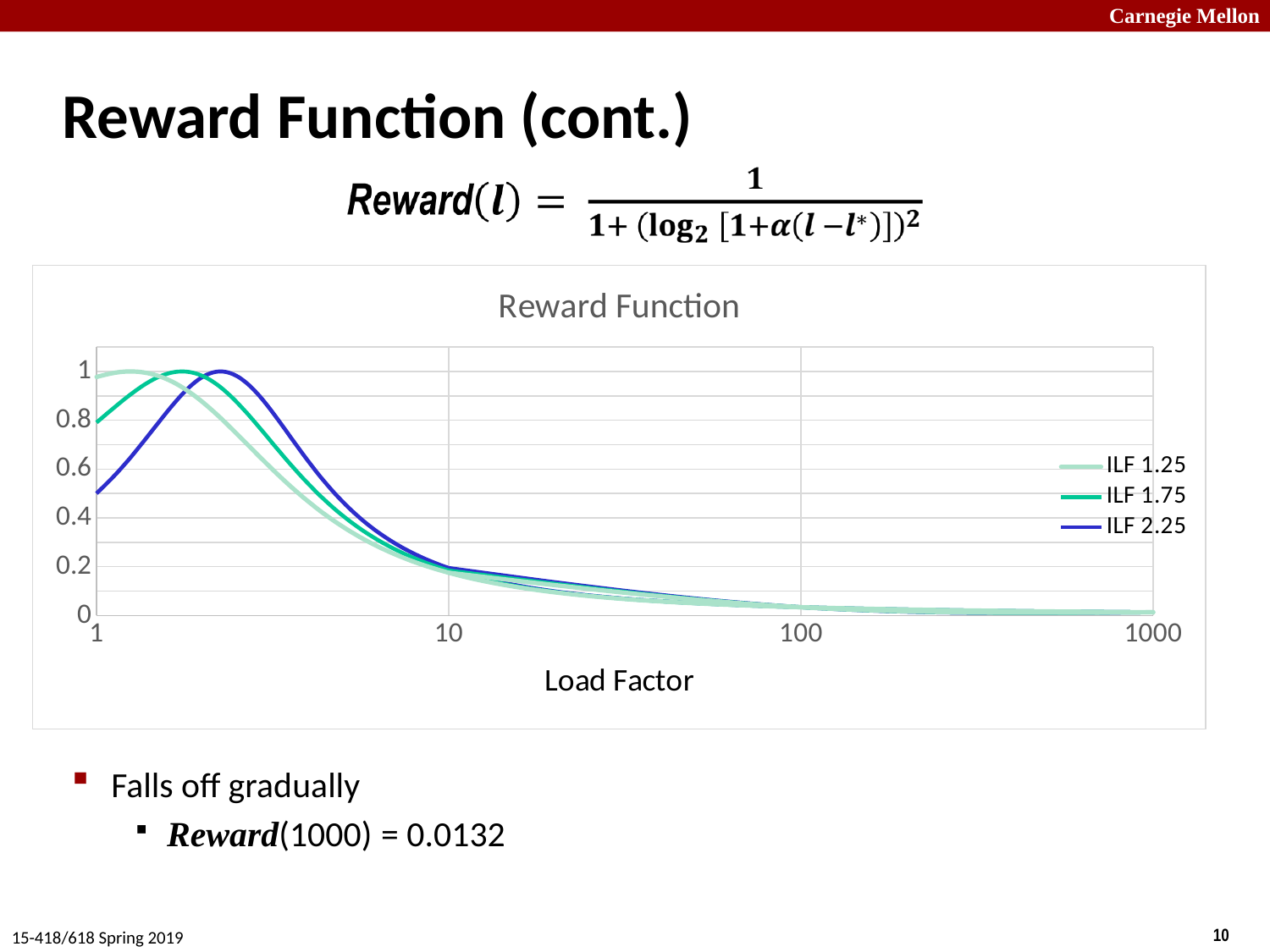
At a load factor of 1, is the value for ILF 1.25 greater or less than 0.8? greater Which series reaches its peak at the largest load factor? ILF 2.25 At a load factor of 10, is the value for ILF 2.25 greater or less than 0.4? less At a load factor of 1, is the value for ILF 2.25 greater or less than 0.6? less Which series has the lowest value at a load factor of 1? ILF 2.25 What is the label of the x axis of the chart? Load Factor What kind of chart is shown on the slide? line chart At a load factor of 1, which series has a larger value, ILF 1.25 or ILF 2.25? ILF 1.25 What is the title of the chart? Reward Function How many series does the legend of the Reward Function chart list? 3 Do the values of the ILF 1.75 series rise or fall as the load factor increases from 10 to 1000? fall